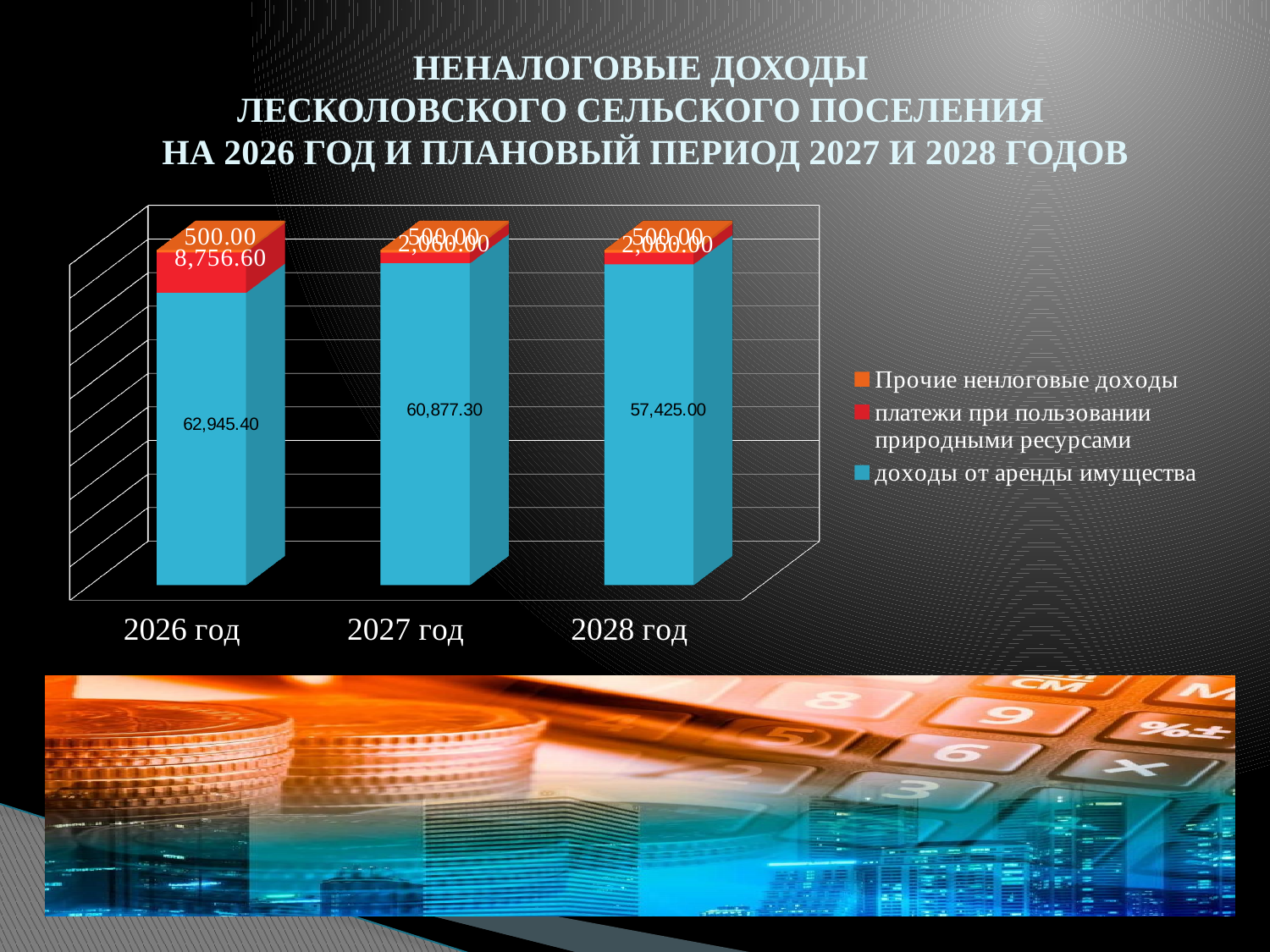
What is the value for Прочие ненлоговые доходы in 2026 год? 500.00 How many series does the legend list? 3 What is the value for платежи при пользовании природными ресурсами in 2026 год? 8,756.60 Which is larger: доходы от аренды имущества in 2027 год or in 2028 год? 2027 год What is the value for доходы от аренды имущества in 2027 год? 60,877.30 What is the total of the stacked bar for 2026 год? 72,202.00 Which year has the lowest value for доходы от аренды имущества? 2028 год What is the value for доходы от аренды имущества in 2026 год? 62,945.40 What is the difference between доходы от аренды имущества in 2026 год and 2028 год? 5,520.40 What is the value for доходы от аренды имущества in 2028 год? 57,425.00 Which year has the highest value for доходы от аренды имущества? 2026 год Do the values for доходы от аренды имущества rise or fall from 2026 год to 2028 год? fall